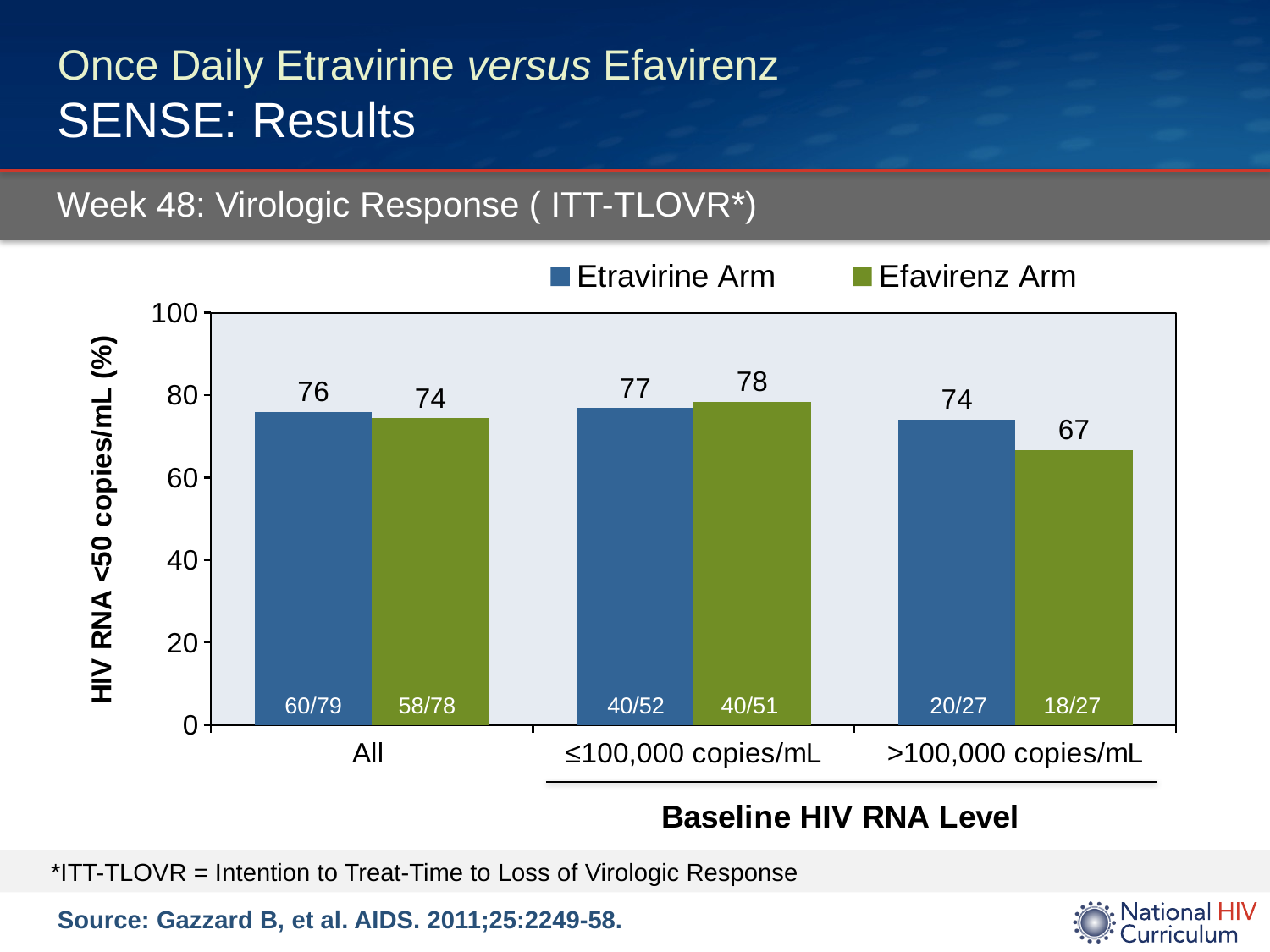
How many series does the legend list? 2 Which category has the lowest value for the Efavirenz Arm? >100,000 copies/mL What is the value for the Efavirenz Arm in the ≤100,000 copies/mL category? 78 Is the value for the Efavirenz Arm in the >100,000 copies/mL category greater or less than 80? less What is the value for the Etravirine Arm in the All category? 76 What kind of chart is shown on the slide? bar chart What is the y-axis label of the chart? HIV RNA <50 copies/mL (%) What is the difference between the Etravirine Arm and Efavirenz Arm values in the >100,000 copies/mL category? 7 What is the value for the Efavirenz Arm in the >100,000 copies/mL category? 67 How many categories are shown on the x axis? 3 Which category has the highest value for the Etravirine Arm? ≤100,000 copies/mL In the All category, which arm has the larger value? Etravirine Arm